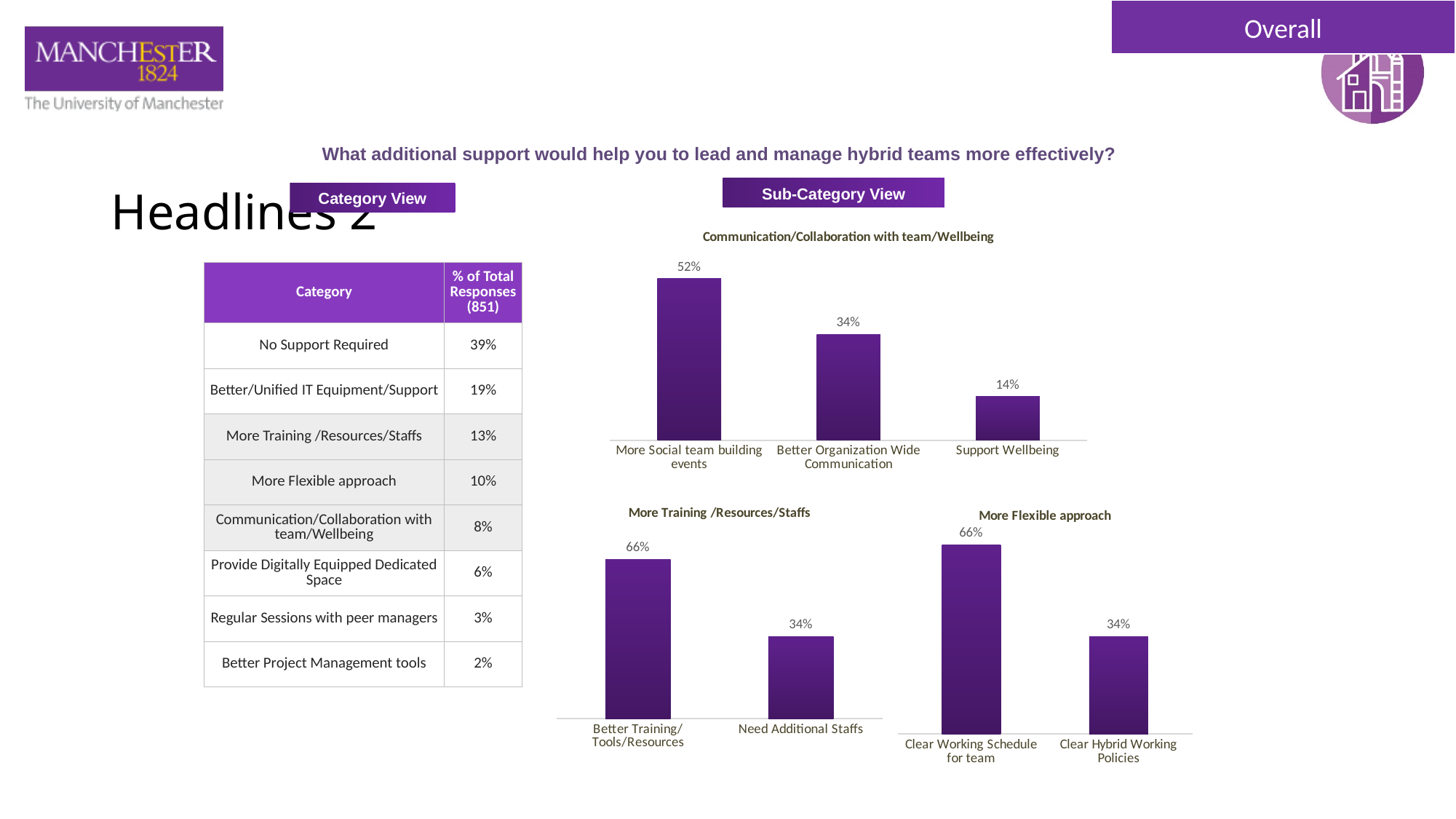
In the "More Training /Resources/Staffs" chart, which is larger: Better Training/Tools/Resources or Need Additional Staffs? Better Training/Tools/Resources In the "Communication/Collaboration with team/Wellbeing" chart, which category has the highest value? More Social team building events In the "Communication/Collaboration with team/Wellbeing" chart, what is the difference between More Social team building events and Better Organization Wide Communication? 18% In the "Communication/Collaboration with team/Wellbeing" chart, what is the value for More Social team building events? 52% In the "More Training /Resources/Staffs" chart, what is the value for Need Additional Staffs? 34% How many categories are shown in the "Communication/Collaboration with team/Wellbeing" chart? 3 In the "Communication/Collaboration with team/Wellbeing" chart, which category has the lowest value? Support Wellbeing What type of chart is the "More Flexible approach" chart? Bar chart In the "More Flexible approach" chart, what is the difference between Clear Working Schedule for team and Clear Hybrid Working Policies? 32% In the "More Flexible approach" chart, what is the value for Clear Hybrid Working Policies? 34% In the "Communication/Collaboration with team/Wellbeing" chart, what is the value for Support Wellbeing? 14% In the "More Training /Resources/Staffs" chart, what is the value for Better Training/Tools/Resources? 66%